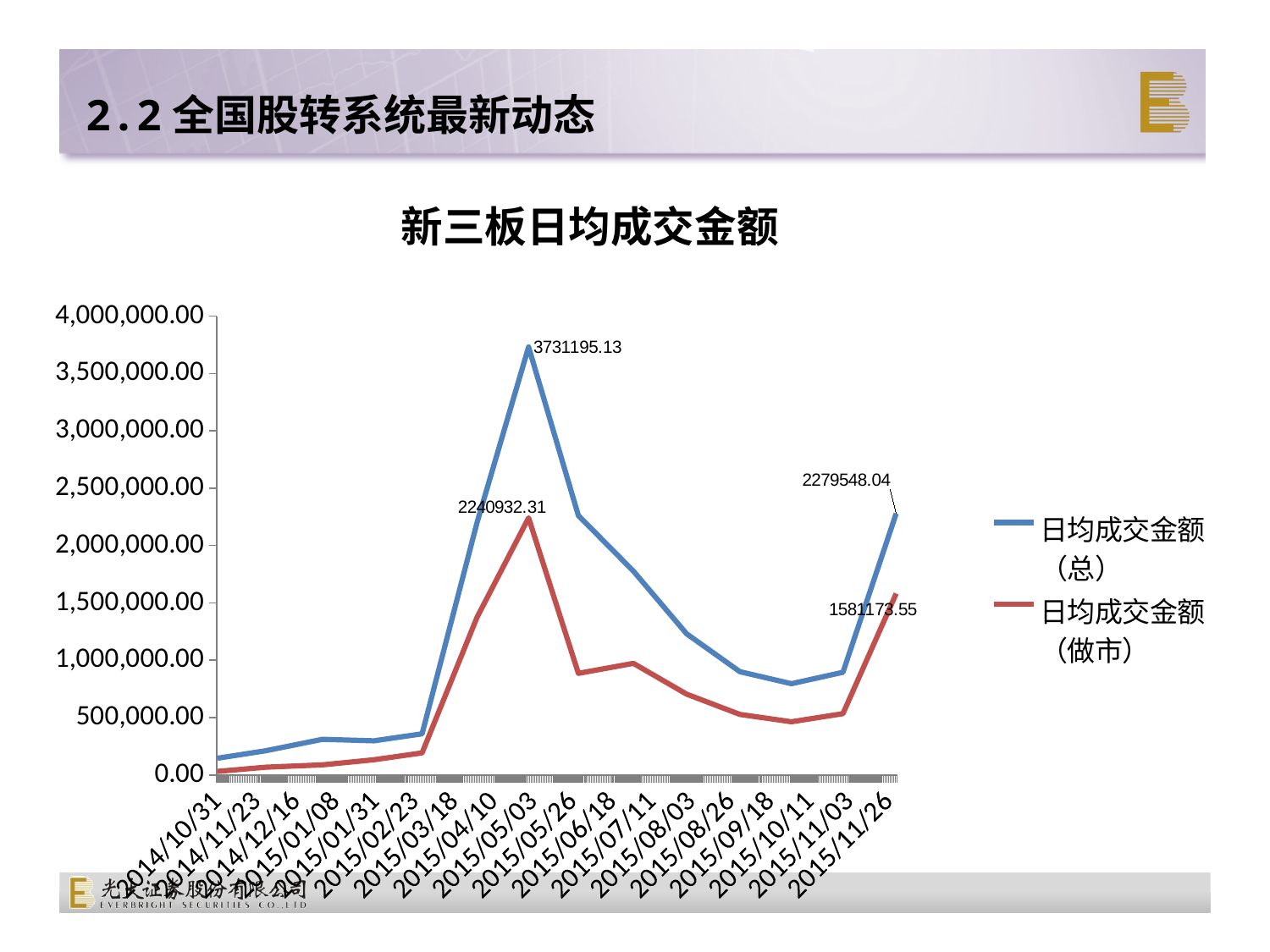
Is the value of 日均成交金额（总） at 2015/10/11 greater or less than 1,000,000.00? less What is the title of the chart? 新三板日均成交金额 What is the peak value labelled on the 日均成交金额（总） line? 3731195.13 At 2015/11/26, which series has the larger value, 日均成交金额（总） or 日均成交金额（做市）? 日均成交金额（总） How many series does the legend list? 2 What is the difference between the labelled peak of 日均成交金额（总） and the labelled peak of 日均成交金额（做市）? 1490262.82 On which date does 日均成交金额（总） reach its highest value? 2015/05/03 What is the value of 日均成交金额（总） at 2015/11/26? 2279548.04 What is the peak value labelled on the 日均成交金额（做市） line? 2240932.31 What is the value of 日均成交金额（做市） at 2015/11/26? 1581173.55 At 2015/11/26, what is the difference between 日均成交金额（总） and 日均成交金额（做市）? 698374.49 What kind of chart is shown on the slide? line chart